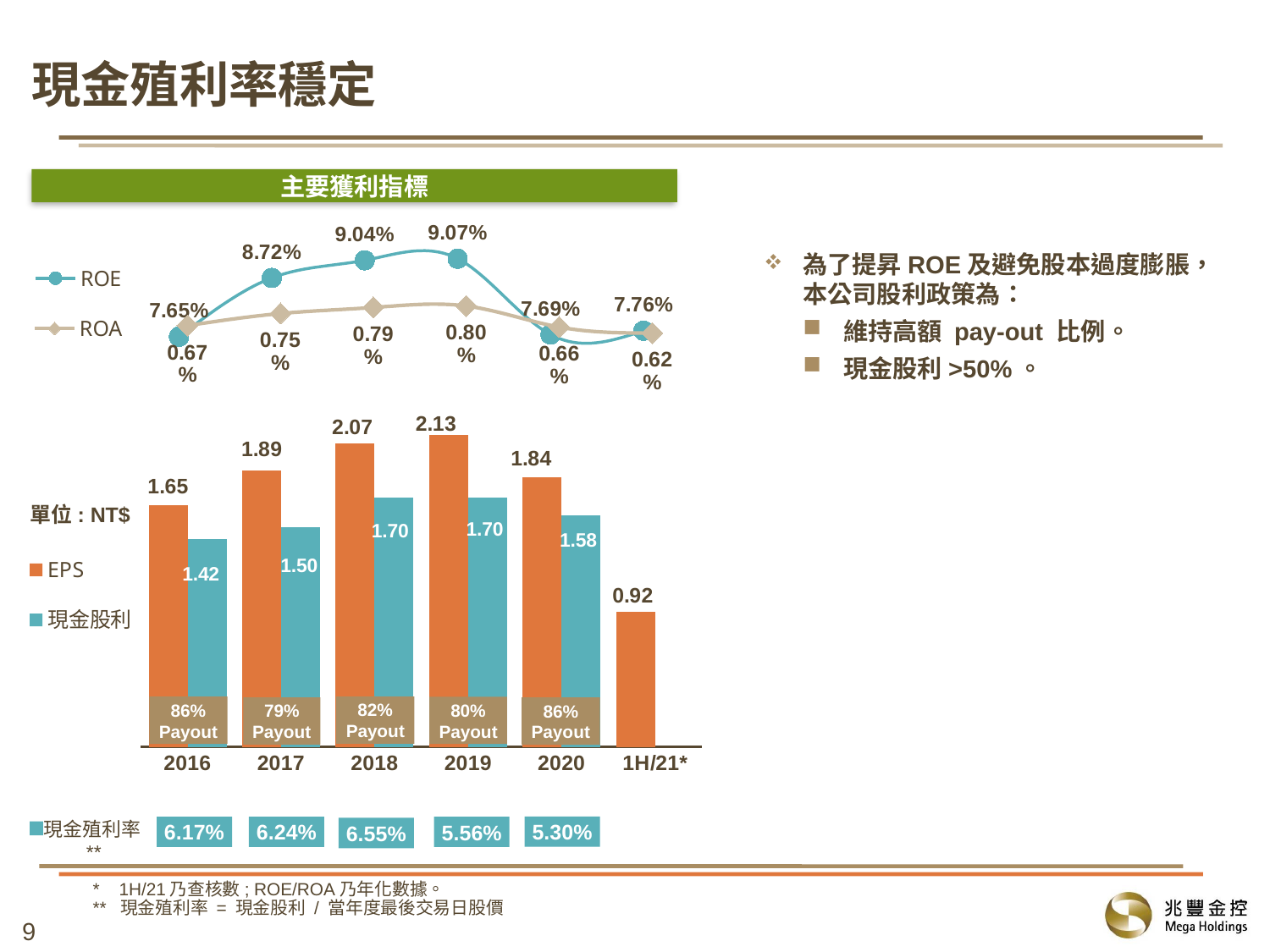
In the top line chart (主要獲利指標), which period has the lowest ROA? 1H/21* In the bottom bar chart, what is the difference between EPS and 現金股利 in 2016? 0.23 What kind of chart is the top chart showing ROE and ROA? Line chart In the top line chart (主要獲利指標), what is the ROA value for 1H/21*? 0.62% In the bottom bar chart, what is the EPS value for 2018? 2.07 How many series does the legend of the top line chart (主要獲利指標) list? 2 In the top line chart (主要獲利指標), which year has the highest ROE? 2019 In the bottom bar chart, which is larger: EPS in 2017 or EPS in 2020? 2017 In the bottom bar chart, what is the 現金股利 value for 2020? 1.58 In the top line chart (主要獲利指標), what is the ROE value for 2019? 9.07% In the bottom bar chart, which year has the highest EPS? 2019 In the bottom bar chart, what is the payout ratio shown for 2017? 79%